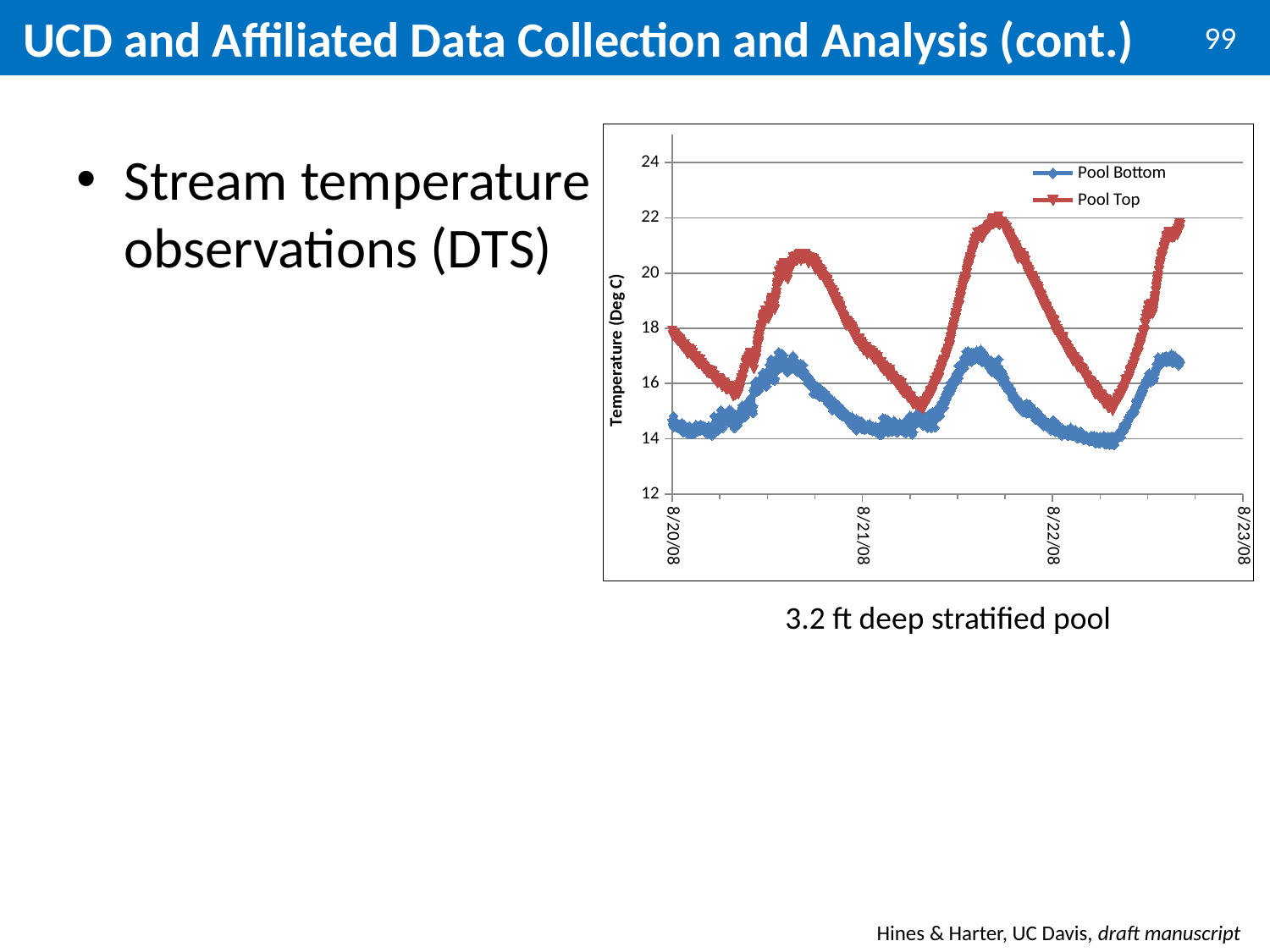
What is the label on the chart's vertical axis? Temperature (Deg C) Is the highest value reached by the Pool Top series greater or less than 20? greater Is the highest value reached by the Pool Bottom series greater or less than 16? greater Is the lowest value reached by the Pool Top series greater or less than 14? greater What is the first date shown on the chart's horizontal axis? 8/20/08 Which series has higher temperatures throughout the chart, Pool Top or Pool Bottom? Pool Top How many series does the chart's legend list? 2 How many date labels are shown on the chart's horizontal axis? 4 What kind of chart is shown on the slide? line chart What are the two series named in the chart's legend? Pool Bottom and Pool Top